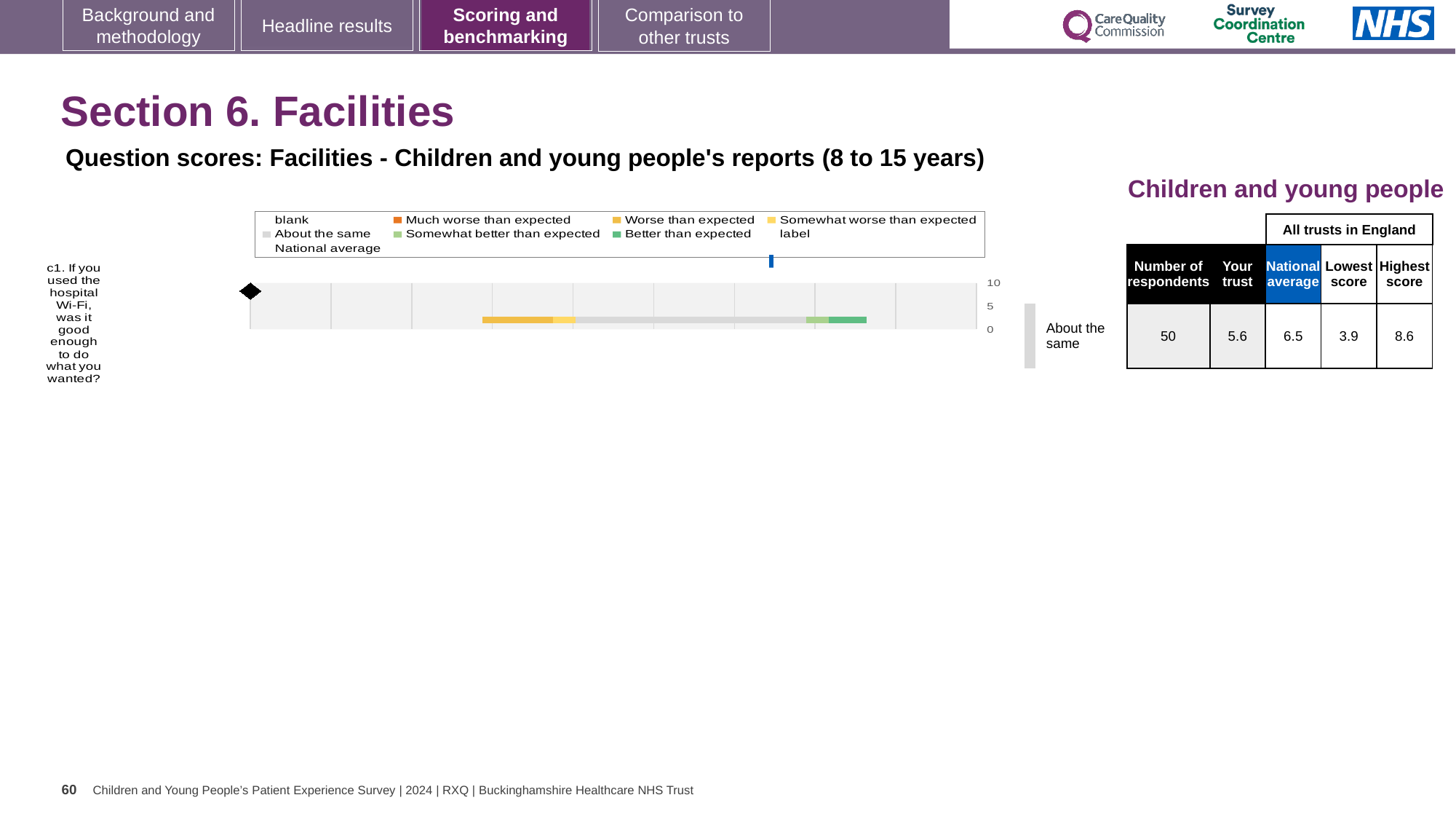
What is the 'Your trust' score for question c1 about the hospital Wi-Fi? 5.6 What benchmark category is the trust's result for question c1 placed in? About the same Which is larger for question c1: the trust's score or the national average? National average How many respondents answered question c1 about the hospital Wi-Fi? 50 How many survey questions are plotted in the chart on this slide? 1 What kind of chart is used to show the question score for c1 on this slide? bar chart What is the difference between the highest and lowest scores across all trusts in England for question c1? 4.7 What is the national average score for question c1 about the hospital Wi-Fi? 6.5 What is the lowest score among all trusts in England for question c1? 3.9 What is the highest score among all trusts in England for question c1? 8.6 What is the difference between the national average and the trust's score for question c1? 0.9 What is the maximum value shown on the score axis of the chart? 10